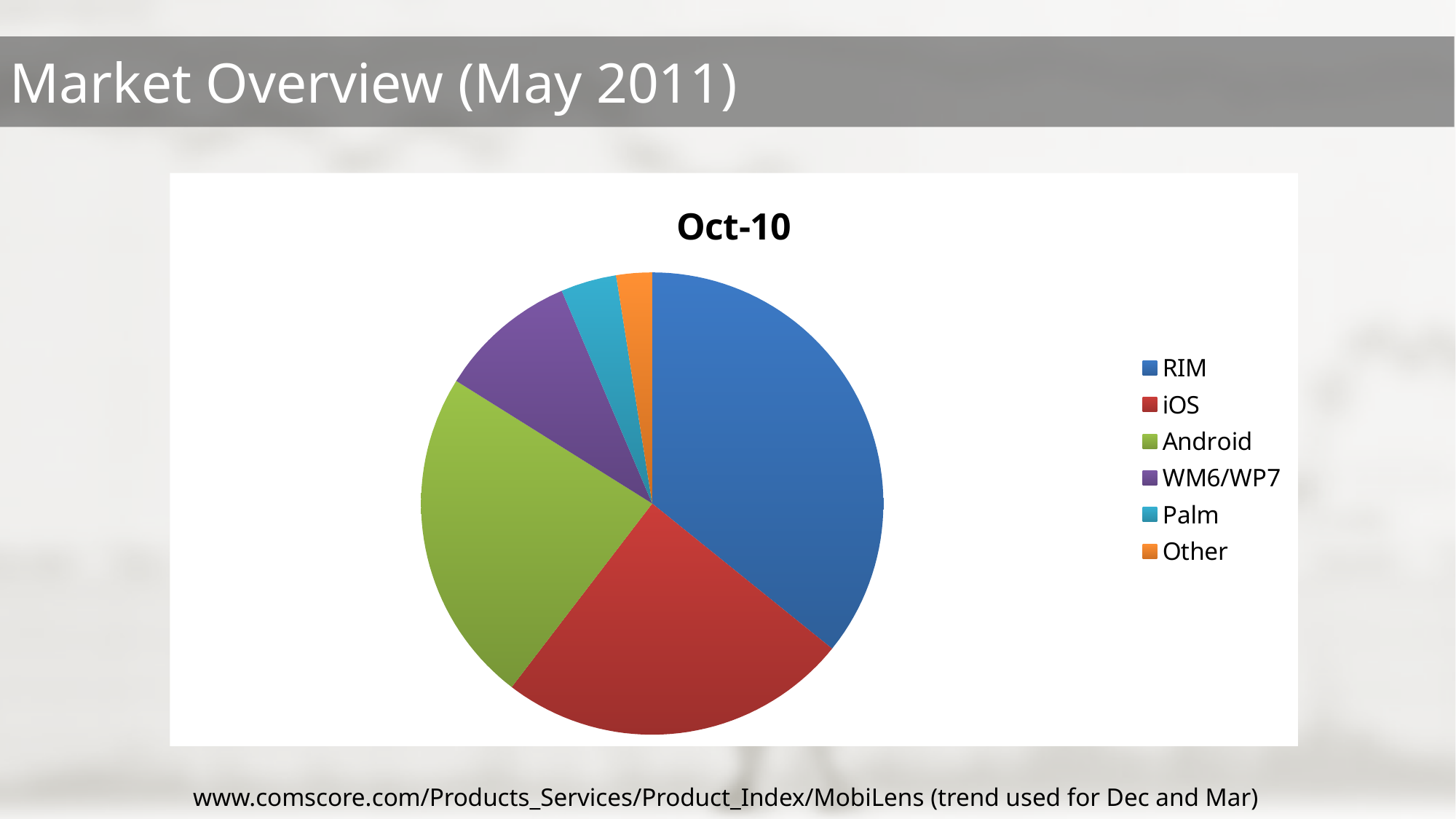
Which category has the smallest slice of the pie? Other Which slice is larger, Android or WM6/WP7? Android Which slice is larger, Palm or Other? Palm Which slice is larger, WM6/WP7 or Palm? WM6/WP7 How many slices does the pie chart have? 6 What is the title of the chart? Oct-10 Which category is shown in purple in the legend? WM6/WP7 Which category has the largest slice of the pie? RIM What kind of chart is shown on the slide? pie chart